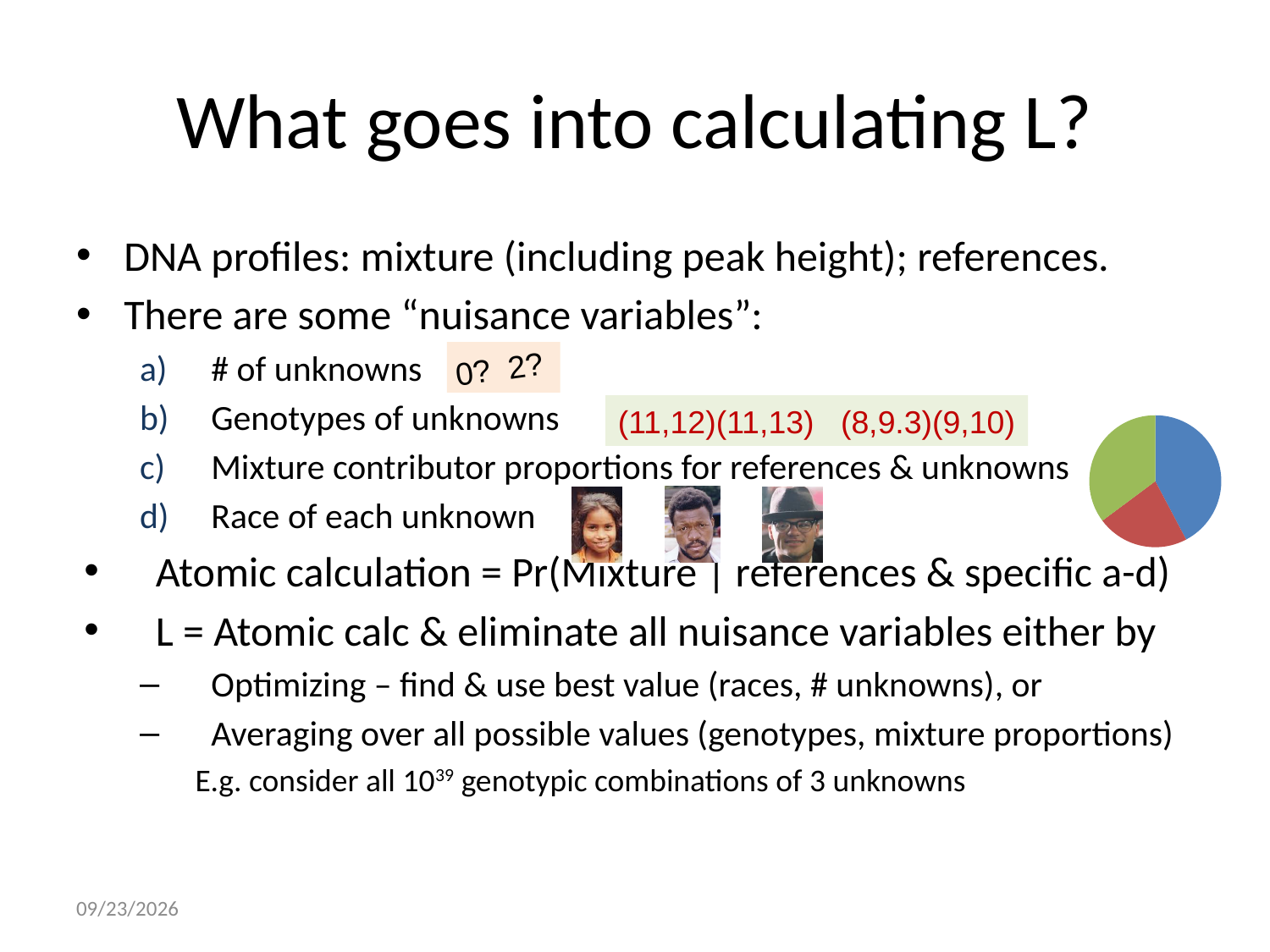
What three colours are used for the slices of the pie chart on the right side of the slide? blue, red and green How many slices does the pie chart on the right side of the slide have? 3 Does the pie chart on the right side of the slide have a legend? No Which colour slice is the smallest in the pie chart on the right side of the slide? red What kind of chart is shown on the right side of the slide? pie chart Which colour slice is the largest in the pie chart on the right side of the slide? blue In the pie chart on the right side of the slide, is the green slice or the red slice larger? green In the pie chart on the right side of the slide, is the blue slice or the red slice larger? blue